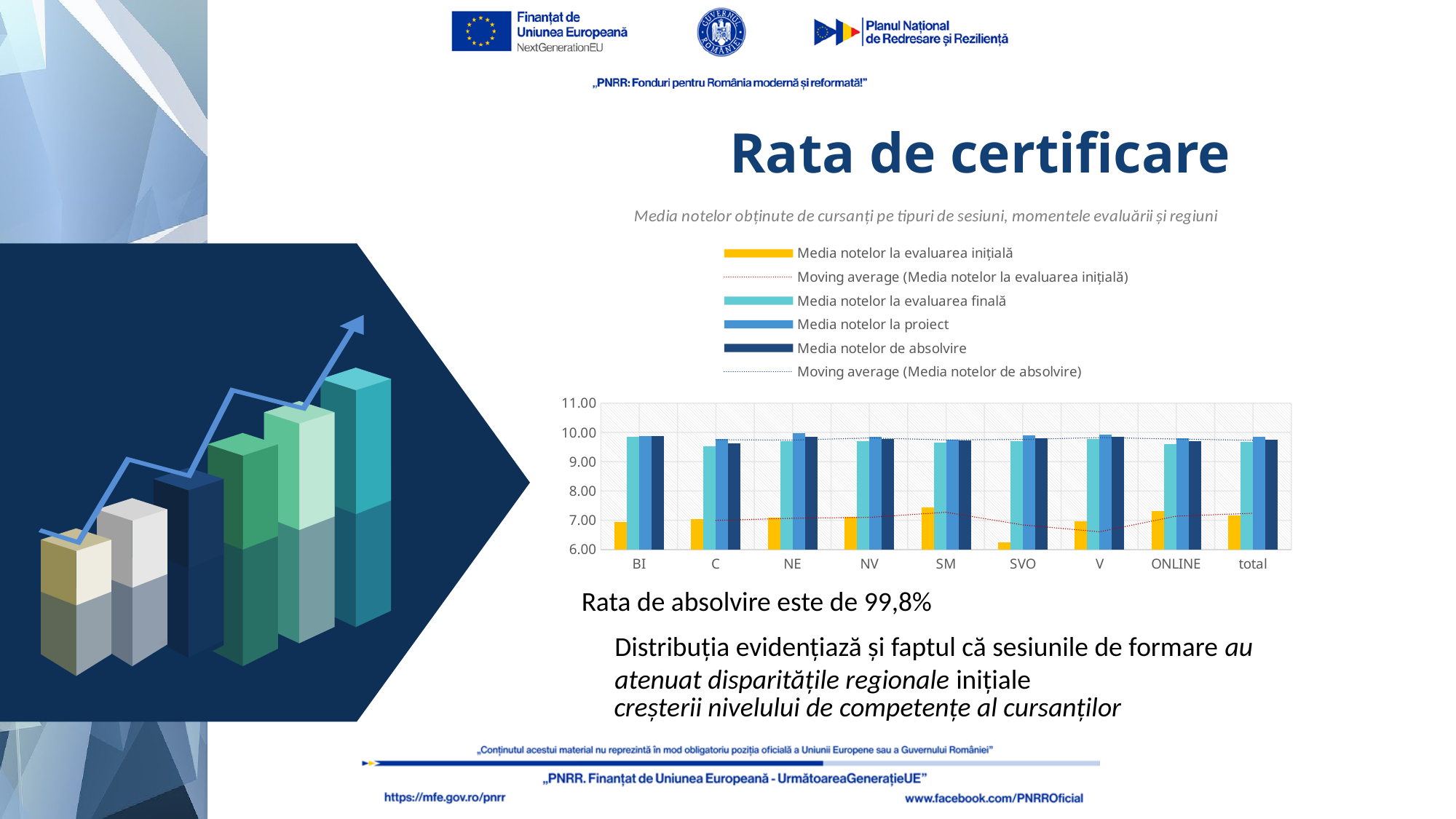
Is the value of 'Media notelor la evaluarea finală' for BI greater or less than 9.00? greater For BI, which is larger: 'Media notelor la evaluarea inițială' or 'Media notelor la evaluarea finală'? Media notelor la evaluarea finală What is the highest value shown on the chart's y axis? 11.00 Which category has the lowest value for 'Media notelor la evaluarea inițială'? SVO For 'Media notelor la evaluarea inițială', which is larger: SM or SVO? SM What kind of chart is shown on the slide? bar chart How many entries does the chart legend list? 6 What is the title of the chart? Media notelor obținute de cursanți pe tipuri de sesiuni, momentele evaluării și regiuni How many categories are shown along the x axis of the chart? 9 Is the value of 'Media notelor la evaluarea inițială' for SM greater or less than 7.00? greater Is the value of 'Media notelor la evaluarea inițială' for SVO greater or less than 7.00? less